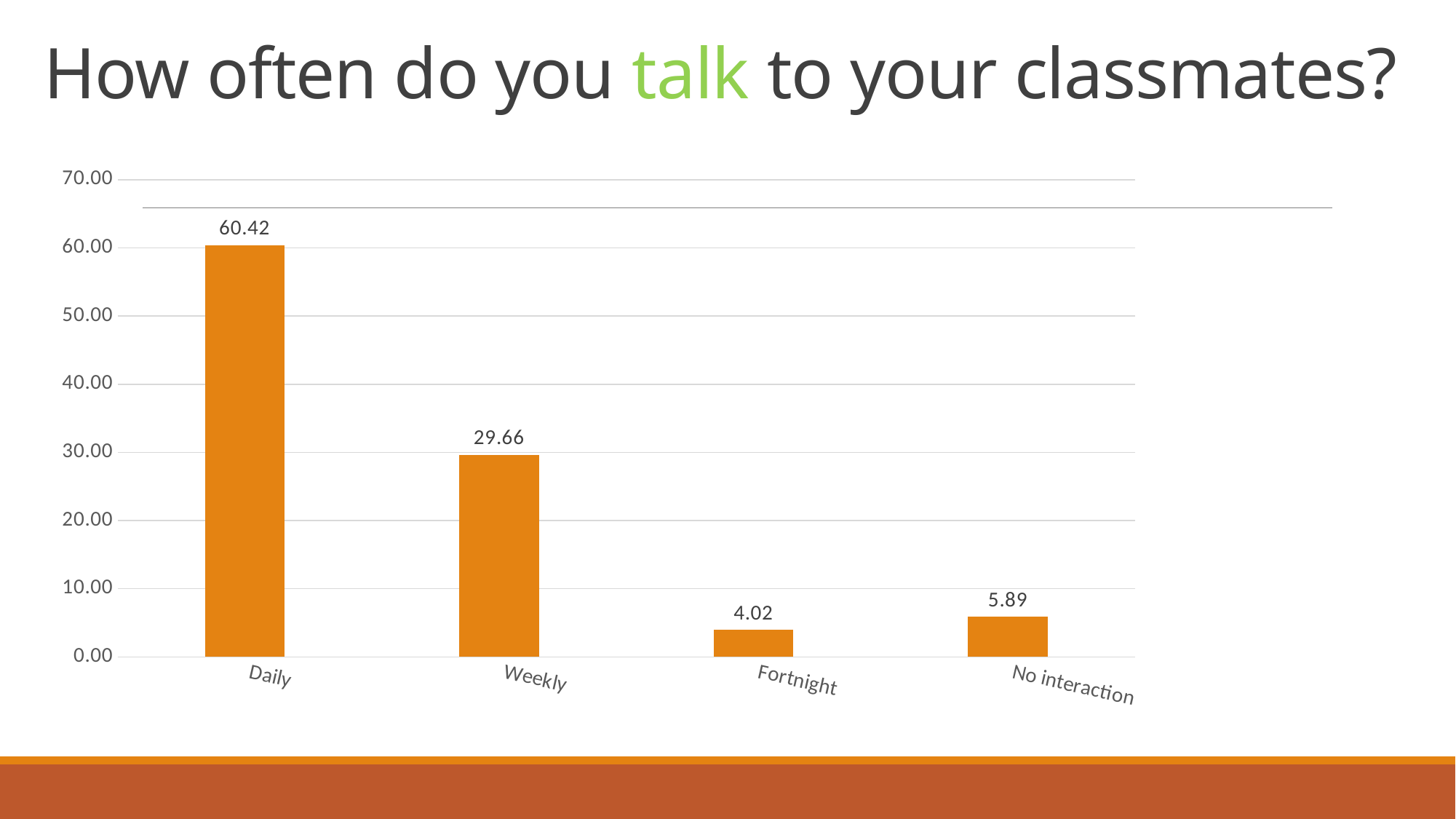
Is the value for Weekly greater or less than 30.00? less Which category has the lowest value? Fortnight What is the value for No interaction? 5.89 What is the value for Fortnight? 4.02 What kind of chart is shown on the slide? bar chart What is the value for Weekly? 29.66 How many categories are shown on the x axis? 4 Which category has the highest value? Daily What is the difference between the values for Daily and Weekly? 30.76 What is the value for Daily? 60.42 What is the title of the slide? How often do you talk to your classmates? Which is larger, the value for No interaction or the value for Fortnight? No interaction